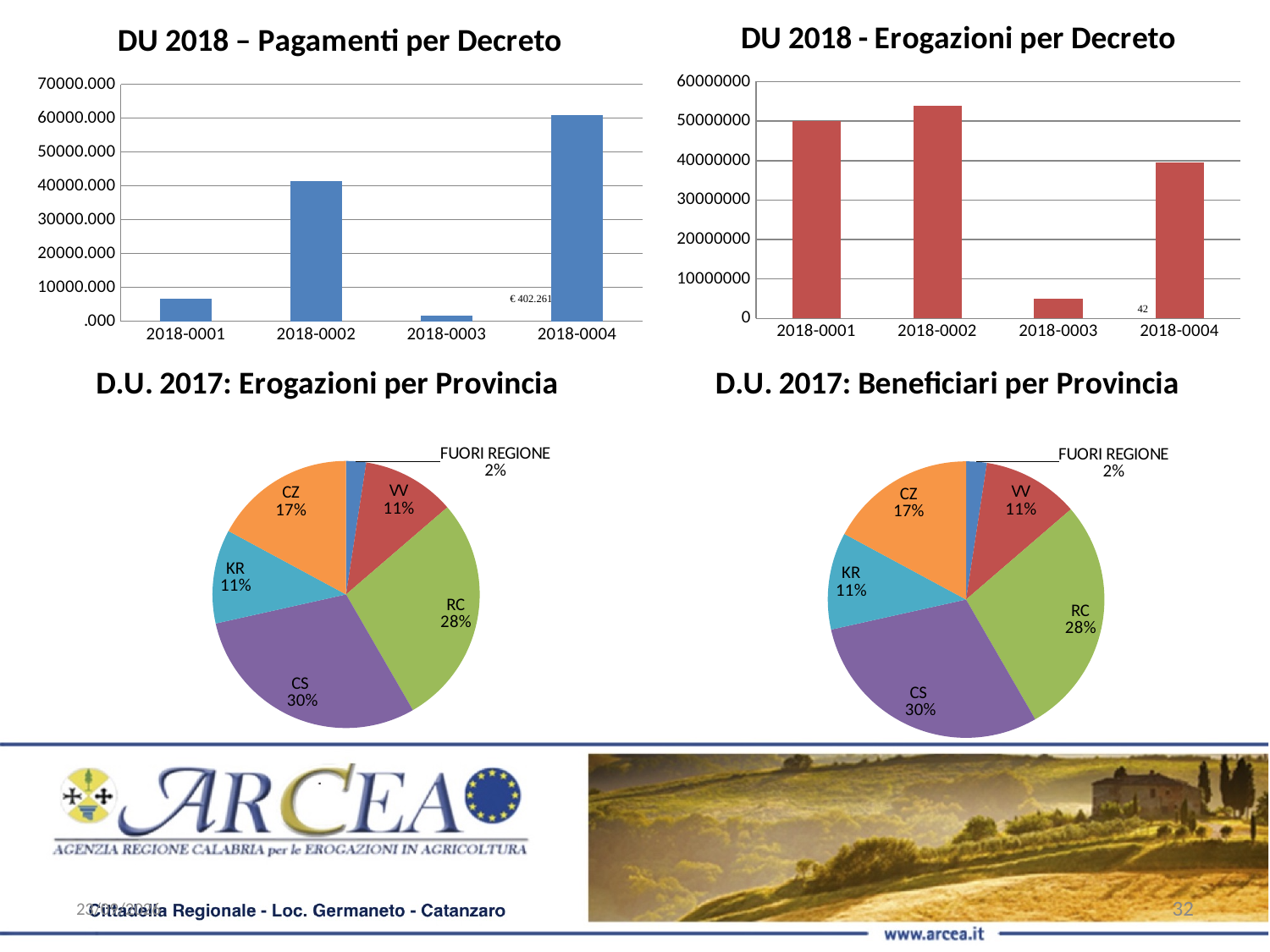
In the 'DU 2018 - Erogazioni per Decreto' chart, which decree has the highest value? 2018-0002 In the 'DU 2018 – Pagamenti per Decreto' chart, which decree has the highest value? 2018-0004 In the 'D.U. 2017: Erogazioni per Provincia' pie chart, what share does CS have? 30% In the 'D.U. 2017: Erogazioni per Provincia' pie chart, which province has the smallest slice? FUORI REGIONE In the 'DU 2018 – Pagamenti per Decreto' chart, which decree has the lowest value? 2018-0003 How many decrees are shown in the 'DU 2018 - Erogazioni per Decreto' chart? 4 How many slices does the 'D.U. 2017: Beneficiari per Provincia' pie chart have? 6 In the 'DU 2018 - Erogazioni per Decreto' chart, is the value for 2018-0004 greater or less than 30000000? greater What kind of chart is 'DU 2018 – Pagamenti per Decreto'? bar chart In the 'D.U. 2017: Beneficiari per Provincia' pie chart, what is the difference between the shares of RC and CZ? 11% In the 'DU 2018 – Pagamenti per Decreto' chart, is the value for 2018-0001 greater or less than 10000.000? less In the 'DU 2018 - Erogazioni per Decreto' chart, which decree has the lowest value? 2018-0003